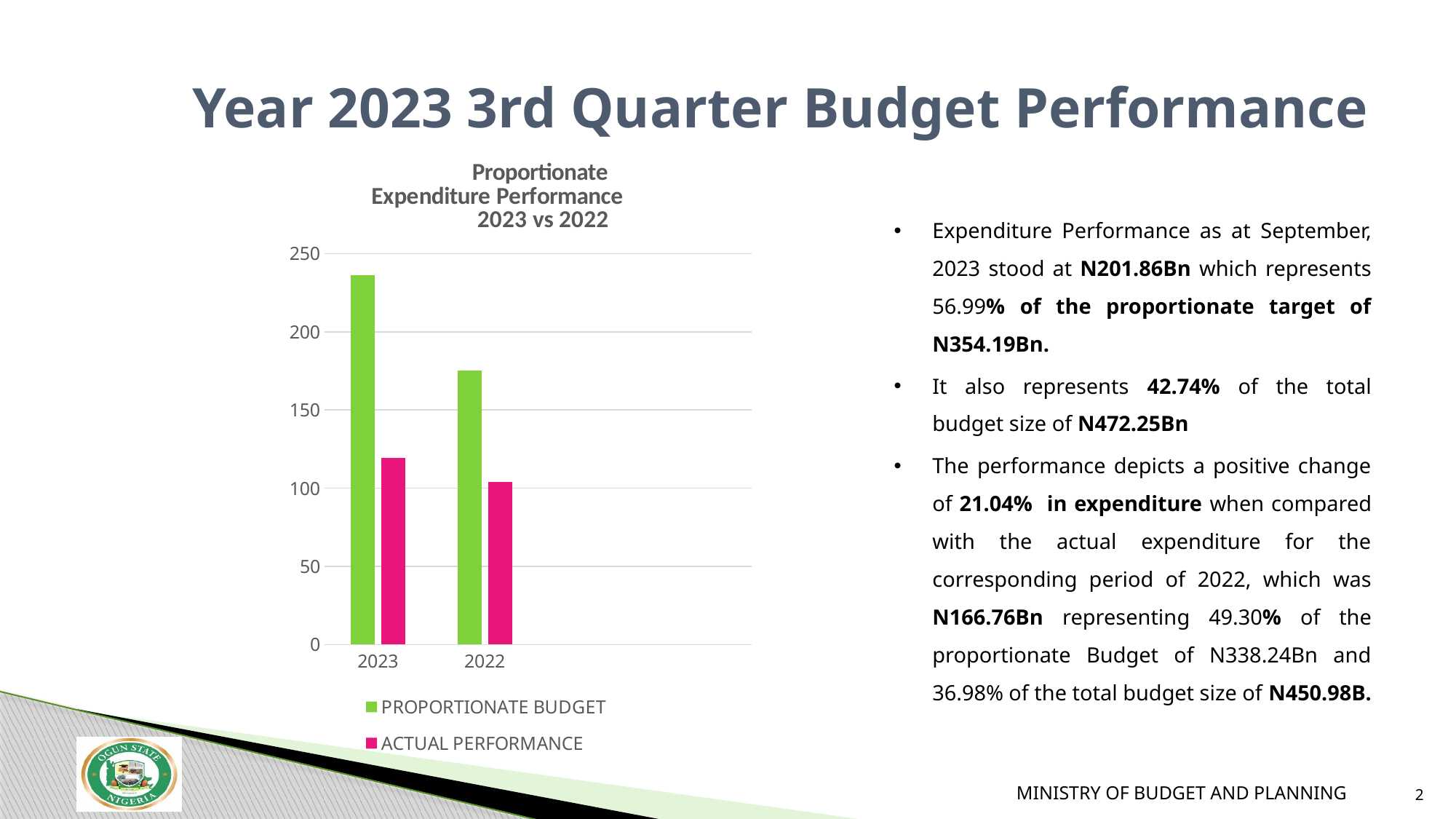
What kind of chart is shown on the slide? bar chart Which bar in the chart is the shortest? ACTUAL PERFORMANCE for 2022 How many series does the chart legend list? 2 Does the PROPORTIONATE BUDGET rise or fall from the 2023 category to the 2022 category along the x axis? fall Is the ACTUAL PERFORMANCE value for 2022 greater or less than 150? less Is the PROPORTIONATE BUDGET value for 2023 greater or less than 200? greater Which is larger, the ACTUAL PERFORMANCE for 2023 or the ACTUAL PERFORMANCE for 2022? ACTUAL PERFORMANCE for 2023 What is the title of the chart? Proportionate Expenditure Performance 2023 vs 2022 Is the PROPORTIONATE BUDGET value for 2022 greater or less than 150? greater Which series is shown in green in the chart? PROPORTIONATE BUDGET How many year categories are shown on the x axis of the chart? 2 Which bar in the chart is the tallest? PROPORTIONATE BUDGET for 2023